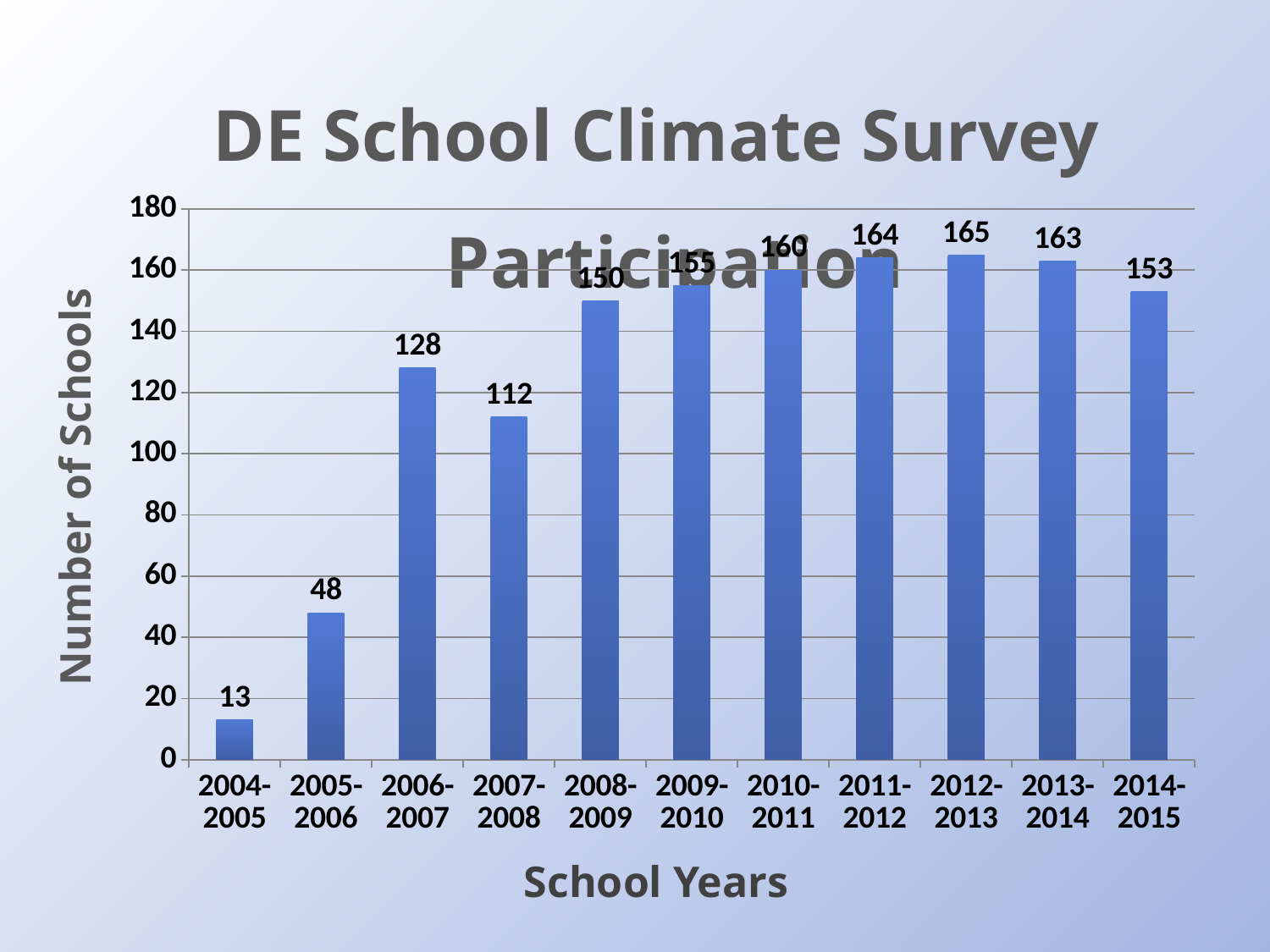
Is the value for 2009-2010 greater or less than 140? greater What is the difference in number of schools between 2006-2007 and 2007-2008? 16 What kind of chart is shown on the slide? bar chart What is the number of schools for 2008-2009? 150 What is the label of the y axis? Number of Schools How many school years are shown on the x axis? 11 Which has more schools, 2005-2006 or 2007-2008? 2007-2008 What is the value for 2014-2015? 153 Do the values rise or fall from 2004-2005 to 2006-2007? rise Which school year has the highest number of schools? 2012-2013 Which school year has the lowest number of schools? 2004-2005 How many schools participated in 2004-2005? 13